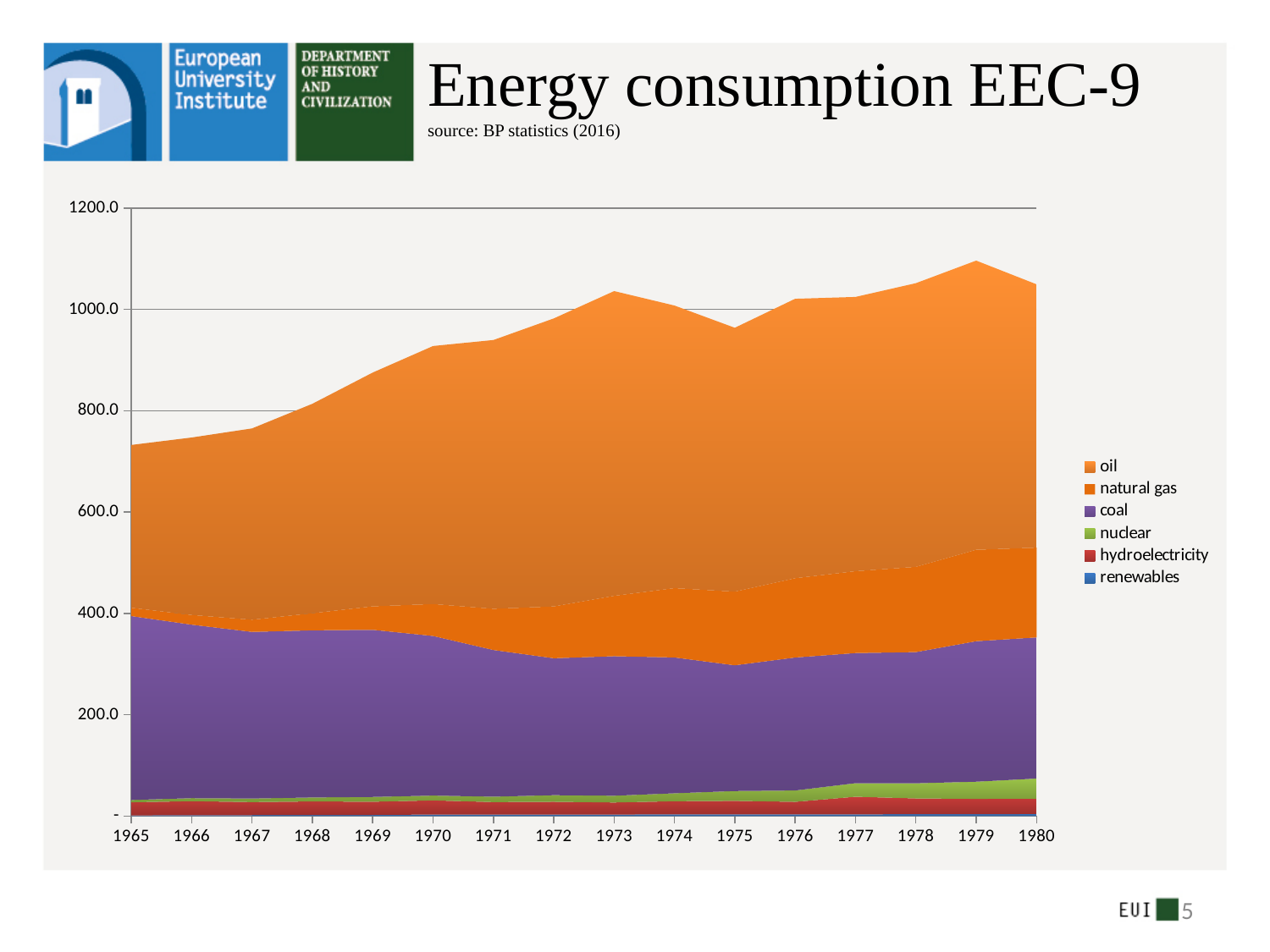
What is the title of the chart? Energy consumption EEC-9 Does total energy consumption generally rise or fall from 1965 to 1980? rise What kind of chart is shown on the slide? stacked area chart How many years are shown along the x axis? 16 Which year has the larger total energy consumption, 1973 or 1975? 1973 In which year is total energy consumption lowest? 1965 Is the total energy consumption in 1975 greater or less than 1000? less Which series is listed first in the legend? oil Is the total energy consumption in 1979 greater or less than 1000? greater How many series does the legend list? 6 In which year is total energy consumption highest? 1979 Is the total energy consumption in 1965 greater or less than 800? less